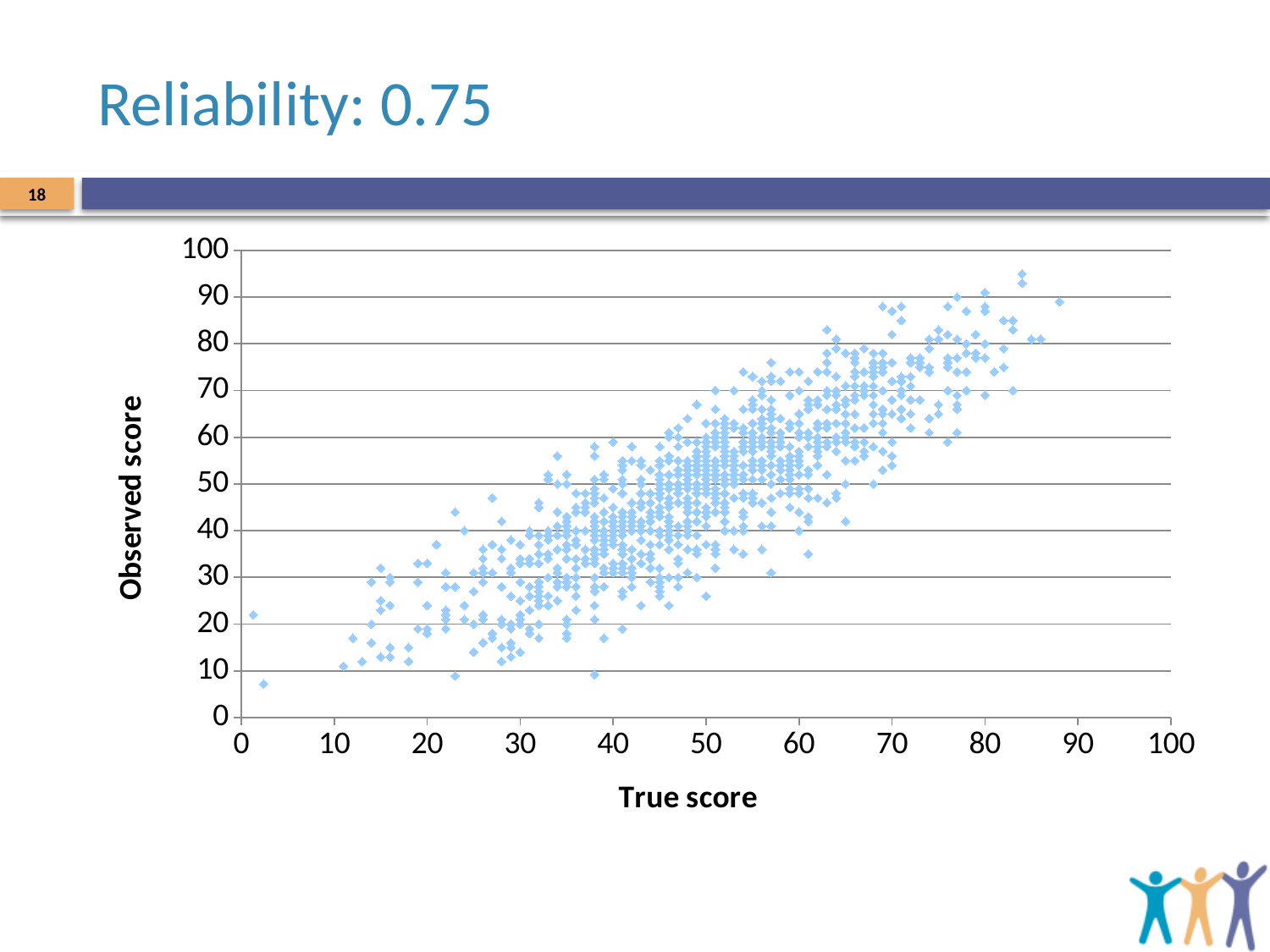
What is the label of the x axis? True score What kind of chart is shown on the slide? scatter plot Is the lowest true score plotted greater or less than 10? less What is the label of the y axis? Observed score Is the highest observed score plotted greater or less than 90? greater What is the maximum value shown on the y axis? 100 Is the lowest observed score plotted greater or less than 10? less As the true score increases along the x axis, do the observed scores generally rise or fall? rise What is the interval between consecutive tick marks on the y axis? 10 What is the maximum value shown on the x axis? 100